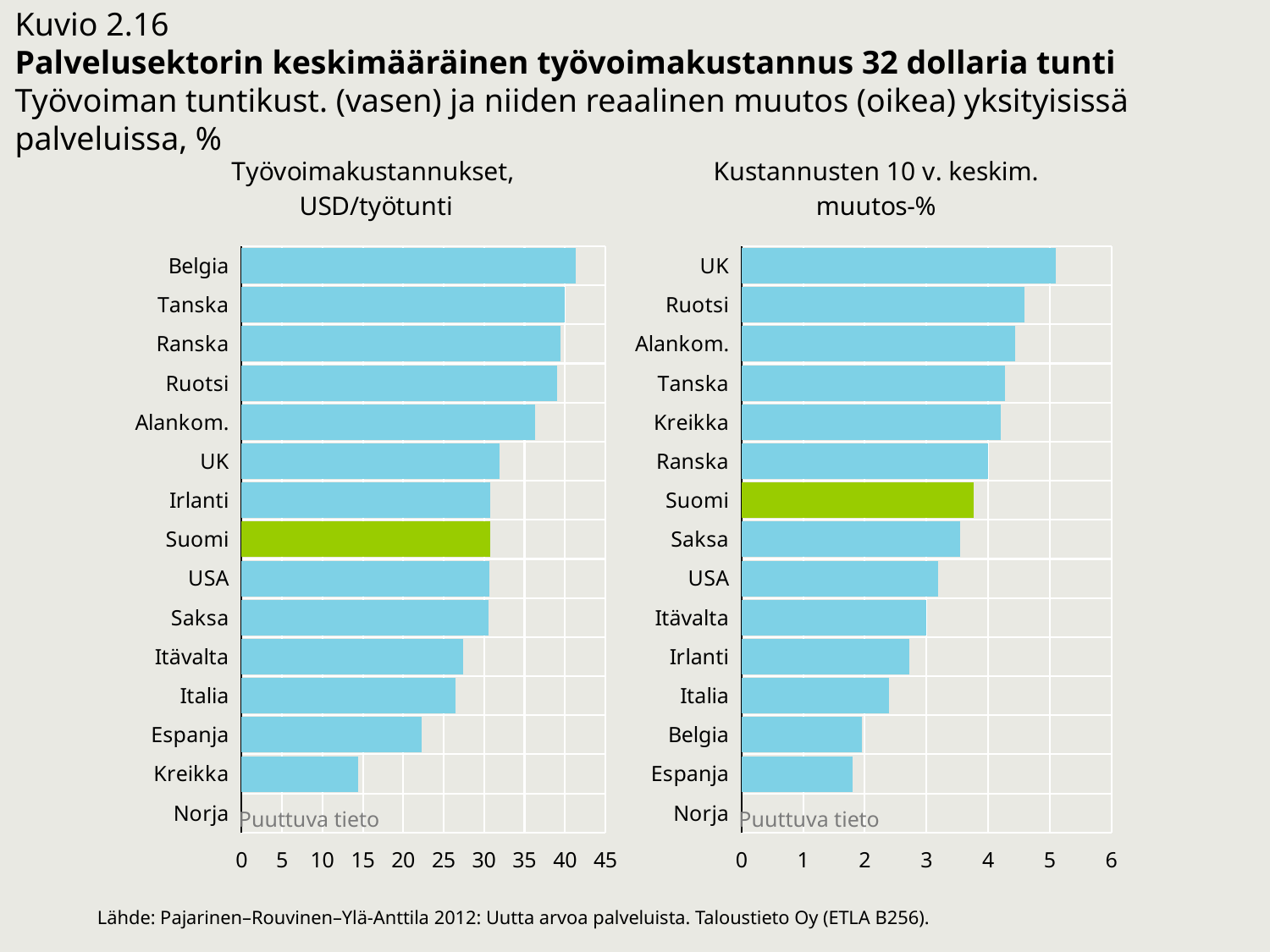
In the right chart (Kustannusten 10 v. keskim. muutos-%), is the value for Espanja greater or less than 2? less In the left chart (Työvoimakustannukset, USD/työtunti), is the value for Belgia greater or less than 40? greater What kind of chart is the left chart, Työvoimakustannukset, USD/työtunti? bar chart In the right chart (Kustannusten 10 v. keskim. muutos-%), which country's bar is coloured green instead of blue? Suomi How many countries are listed on the vertical axis of the left chart (Työvoimakustannukset, USD/työtunti)? 15 In the right chart (Kustannusten 10 v. keskim. muutos-%), which country has the highest value? UK In the left chart (Työvoimakustannukset, USD/työtunti), is the value for Kreikka greater or less than 20? less In the right chart (Kustannusten 10 v. keskim. muutos-%), which is larger, the value for Ruotsi or the value for Italia? Ruotsi In the left chart (Työvoimakustannukset, USD/työtunti), which country with a plotted bar has the lowest labour cost? Kreikka In the left chart (Työvoimakustannukset, USD/työtunti), which country has the highest labour cost? Belgia